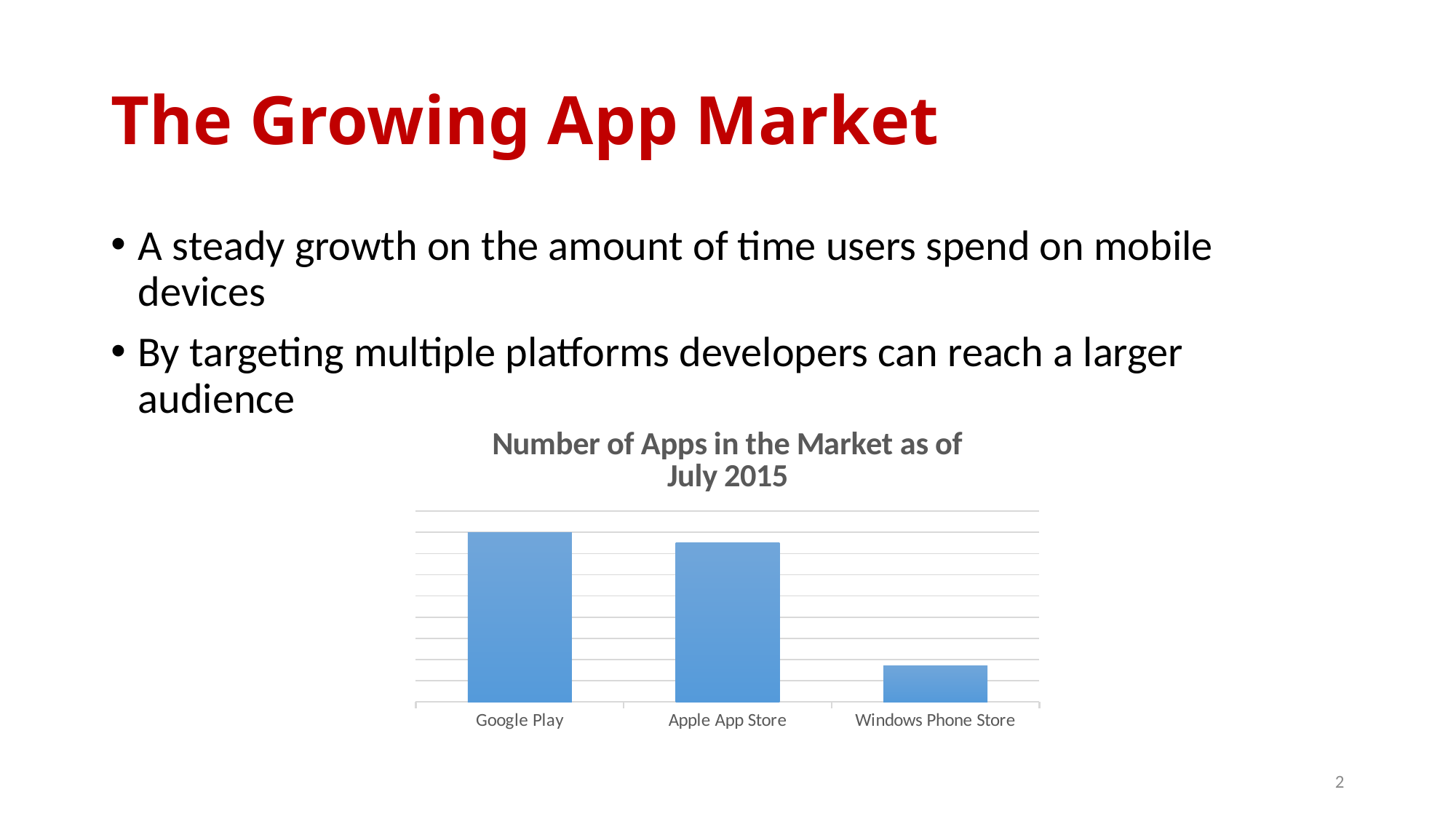
Do the bar values rise or fall from left to right across the x axis? fall Which has more apps, Google Play or Apple App Store? Google Play Which category has the highest number of apps? Google Play Which category has the lowest number of apps? Windows Phone Store What is the title of the chart? Number of Apps in the Market as of July 2015 Which has more apps, Apple App Store or Windows Phone Store? Apple App Store What kind of chart is shown on the slide? bar chart What colour are the bars in the chart? blue How many categories are shown in the chart? 3